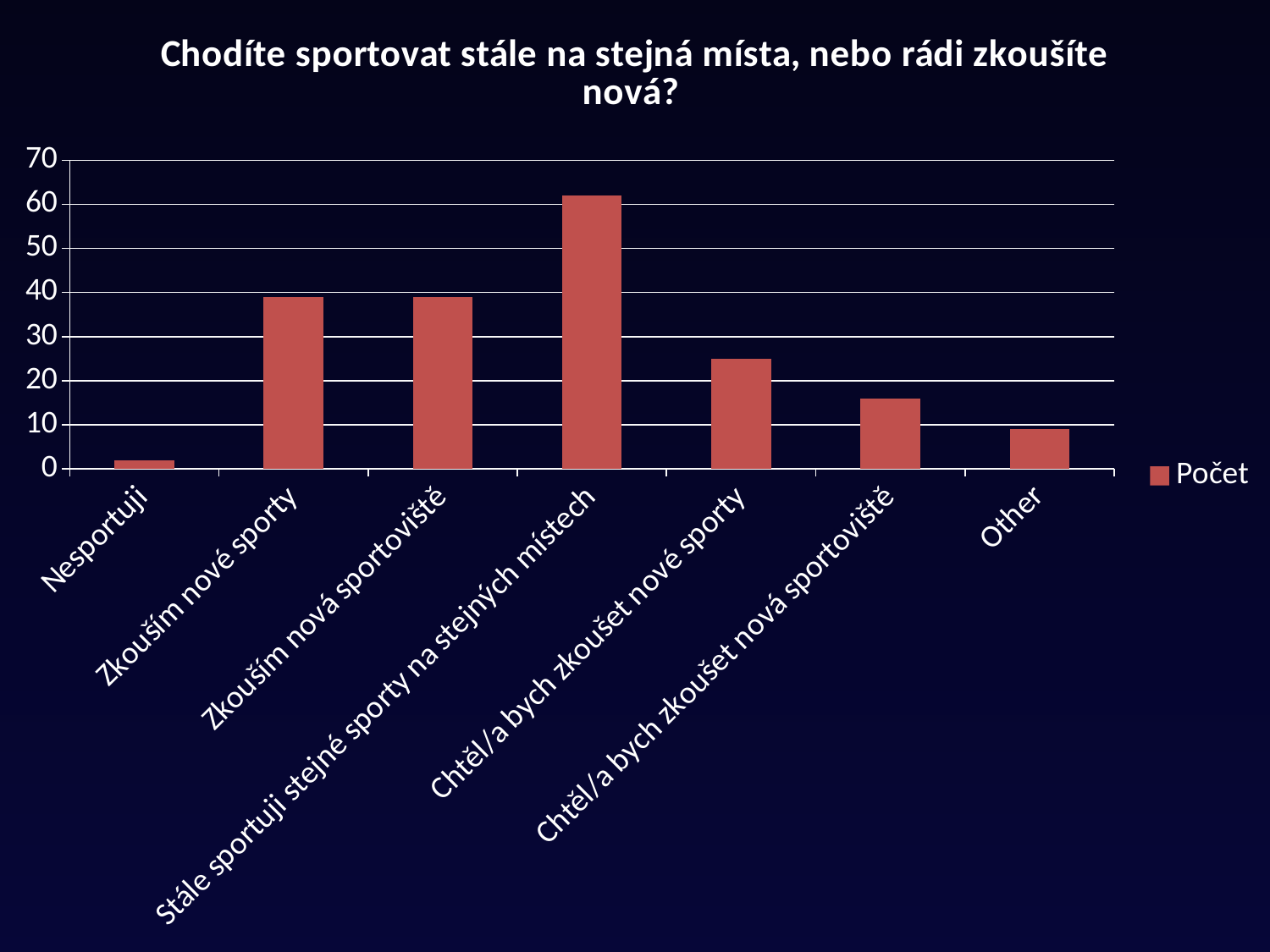
What type of chart is shown on the slide? bar chart Is the value for Chtěl/a bych zkoušet nové sporty greater or less than 20? greater Which category has the lowest value? Nesportuji Which category has the highest value? Stále sportuji stejné sporty na stejných místech What is the name of the series shown in the legend? Počet Is the value for Stále sportuji stejné sporty na stejných místech greater or less than 50? greater Is the value for Nesportuji greater or less than 10? less Which is larger, the value for Stále sportuji stejné sporty na stejných místech or the value for Chtěl/a bych zkoušet nové sporty? Stále sportuji stejné sporty na stejných místech How many categories are shown on the x axis? 7 How many series does the legend list? 1 Which is larger, the value for Other or the value for Chtěl/a bych zkoušet nová sportoviště? Chtěl/a bych zkoušet nová sportoviště